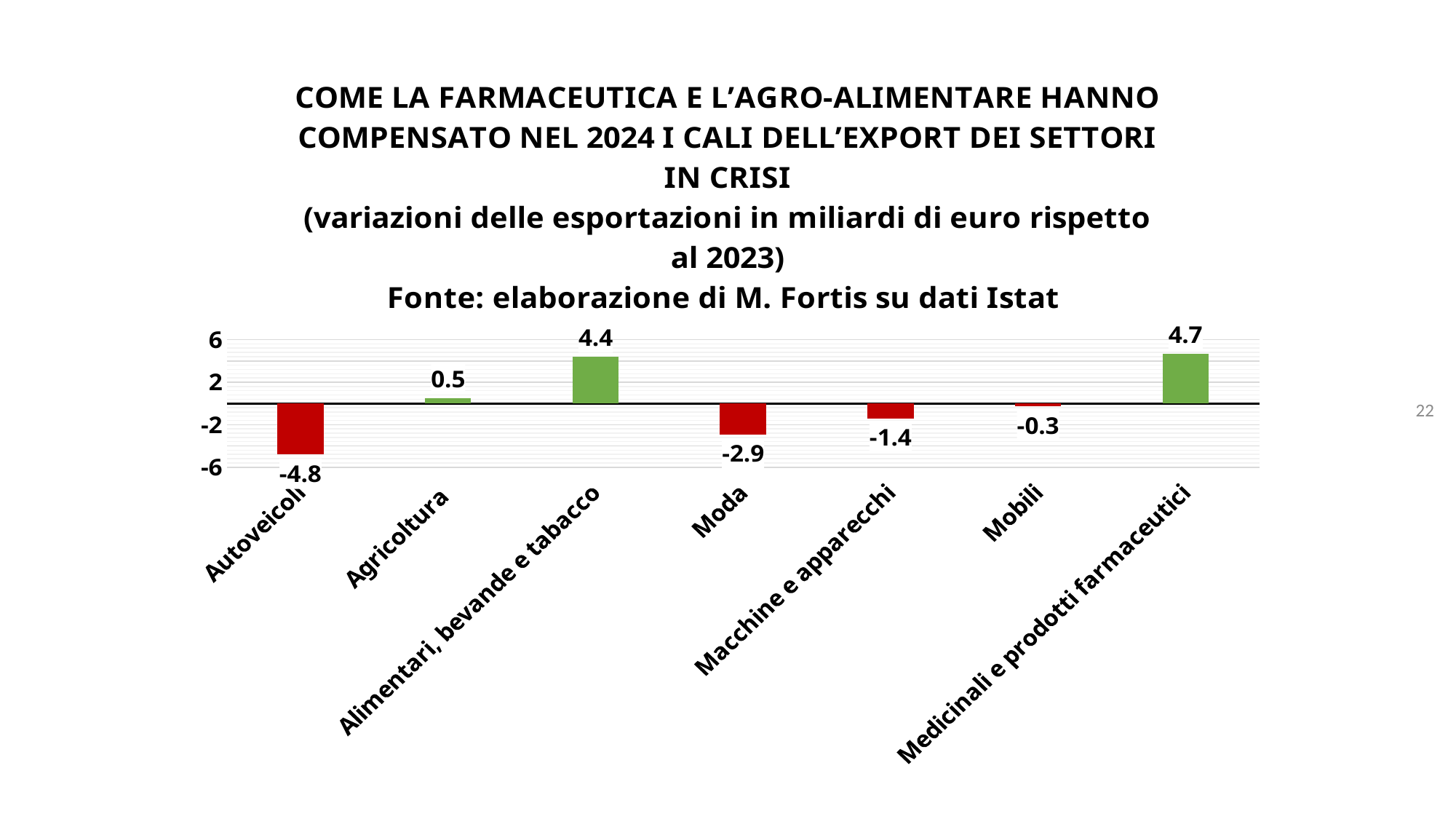
What is the value for Alimentari, bevande e tabacco? 4.4 What colour are the bars with negative values? Red What is the value for Autoveicoli? -4.8 What is the difference between the values for Autoveicoli and Moda? 1.9 What is the value for Medicinali e prodotti farmaceutici? 4.7 Which category has the highest value? Medicinali e prodotti farmaceutici What is the value for Mobili? -0.3 Which category has the lowest value? Autoveicoli How many categories are shown in the chart? 7 What kind of chart is shown on the slide? Bar chart What is the difference between the values for Medicinali e prodotti farmaceutici and Alimentari, bevande e tabacco? 0.3 Which has a larger value, Moda or Macchine e apparecchi? Macchine e apparecchi